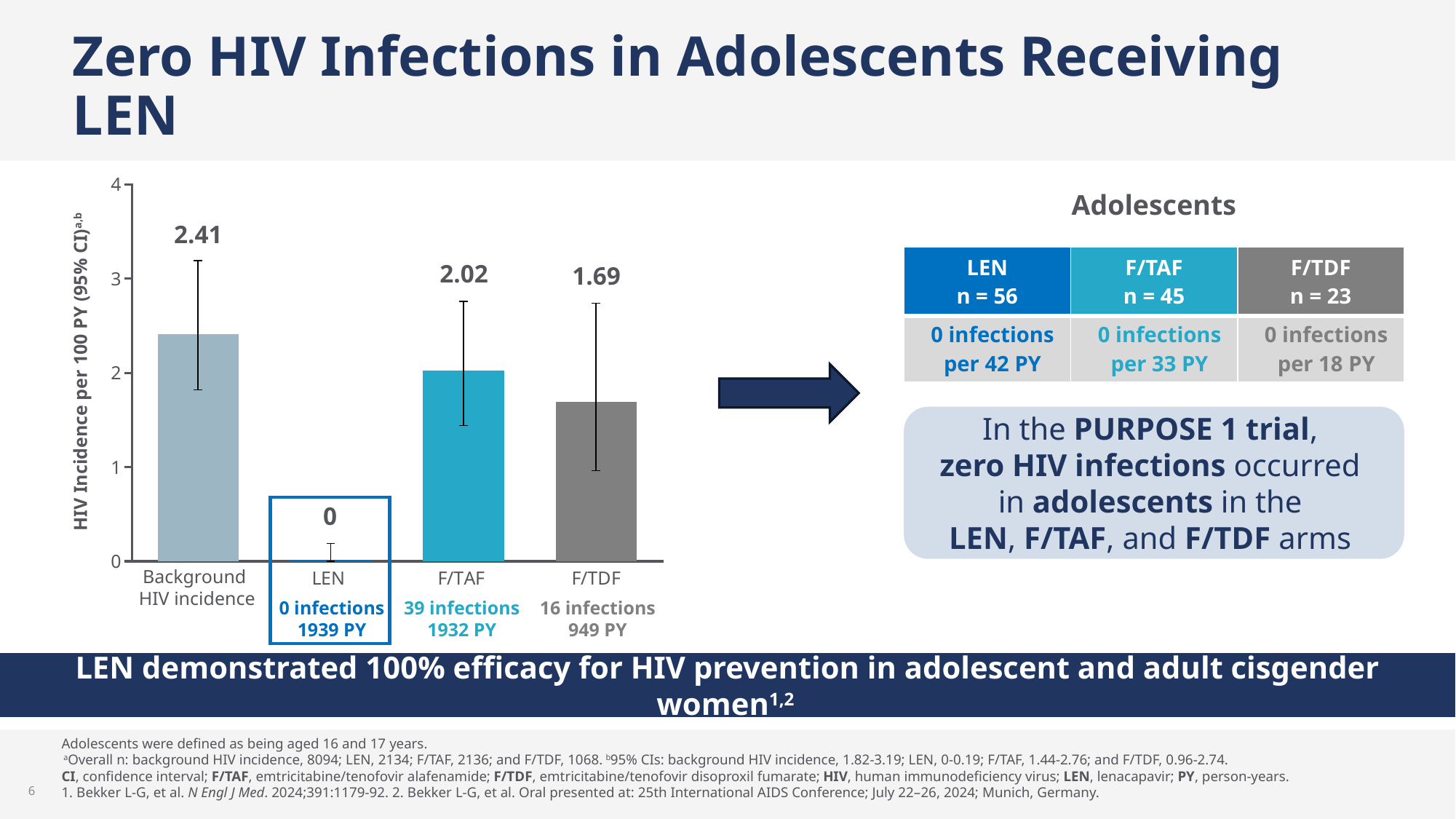
Which category has the lowest HIV incidence per 100 PY? LEN Which has a higher HIV incidence per 100 PY, Background HIV incidence or F/TAF? Background HIV incidence What is the HIV incidence per 100 PY for the LEN arm? 0 Is the HIV incidence per 100 PY for F/TDF greater or less than 2? less What is the label of the y axis of the chart? HIV Incidence per 100 PY (95% CI) Which category has the highest HIV incidence per 100 PY? Background HIV incidence What is the HIV incidence per 100 PY for Background HIV incidence? 2.41 What kind of chart is shown on the slide? Bar chart How many categories are shown on the x axis of the chart? 4 What is the HIV incidence per 100 PY for the F/TAF arm? 2.02 What is the HIV incidence per 100 PY for the F/TDF arm? 1.69 What is the difference in HIV incidence per 100 PY between F/TAF and F/TDF? 0.33